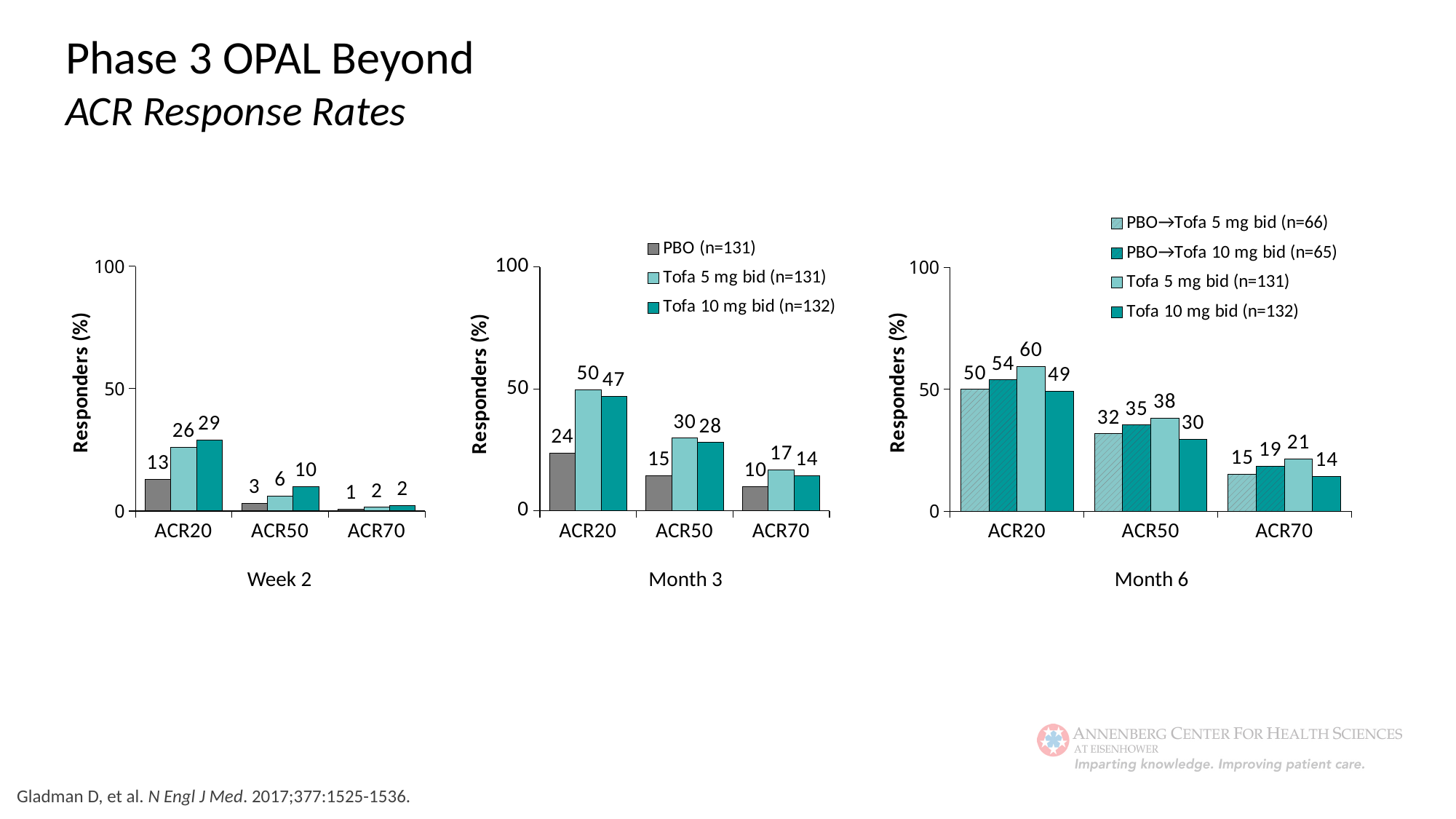
In the Month 3 chart, is the ACR20 value for Tofa 10 mg bid greater or less than 50? less In the Month 3 chart, what is the difference between the ACR20 response rates for Tofa 5 mg bid and PBO? 26 In the Month 3 chart, do the PBO values rise or fall from ACR20 to ACR70? Fall In the Month 6 chart, which group has the highest ACR20 response rate? Tofa 5 mg bid How many categories are shown on the x axis of the Week 2 chart? 3 In the Month 6 chart, which is larger: the ACR50 rate for PBO→Tofa 10 mg bid or for Tofa 10 mg bid? PBO→Tofa 10 mg bid In the Month 6 chart, what is the ACR70 response rate for Tofa 5 mg bid? 21 What kind of chart is the Month 3 chart? Bar chart In the Week 2 chart, which group has the lowest ACR50 response rate? PBO In the Week 2 chart, what is the ACR20 response rate for Tofa 10 mg bid? 29 In the Month 3 chart, what is the ACR50 response rate for PBO? 15 How many series does the legend of the Month 6 chart list? 4